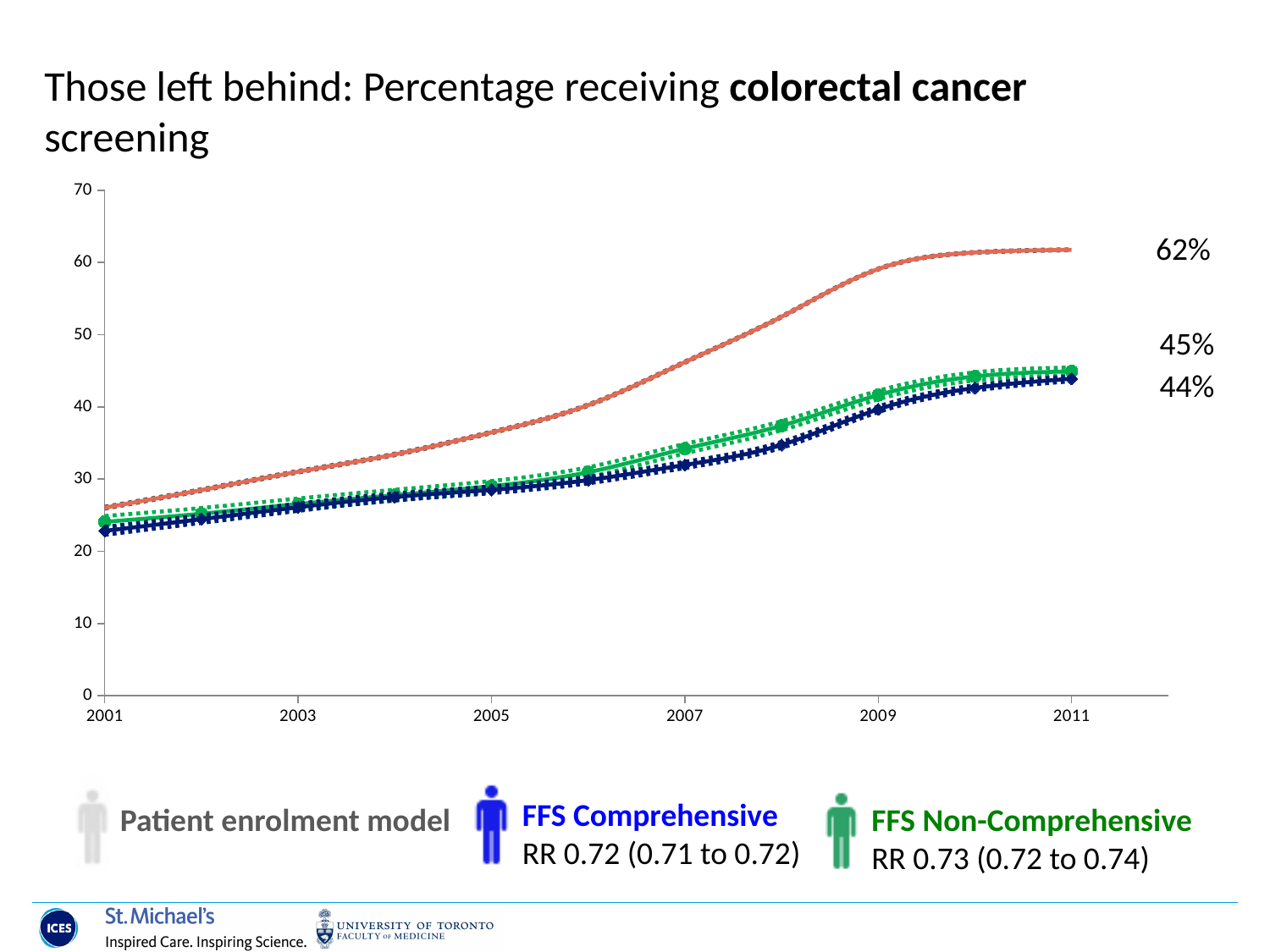
What kind of chart is shown on the slide? line chart What is the difference between the 2011 values for the Patient enrolment model and FFS Comprehensive? 18 percentage points Which series has the lowest value in 2011? FFS Comprehensive What percentage is shown for FFS Comprehensive at the end of the series in 2011? 44% What RR value is shown for FFS Comprehensive? RR 0.72 (0.71 to 0.72) Is the value for the Patient enrolment model in 2001 greater or less than 30? less In 2011, which is larger: FFS Non-Comprehensive or FFS Comprehensive? FFS Non-Comprehensive Do the values for all three series rise or fall from 2001 to 2011? rise What percentage is shown for FFS Non-Comprehensive at the end of the series in 2011? 45% Which series has the highest value in 2011? Patient enrolment model How many series does the legend list? 3 What percentage receiving colorectal cancer screening is shown for the Patient enrolment model at the end of the series in 2011? 62%